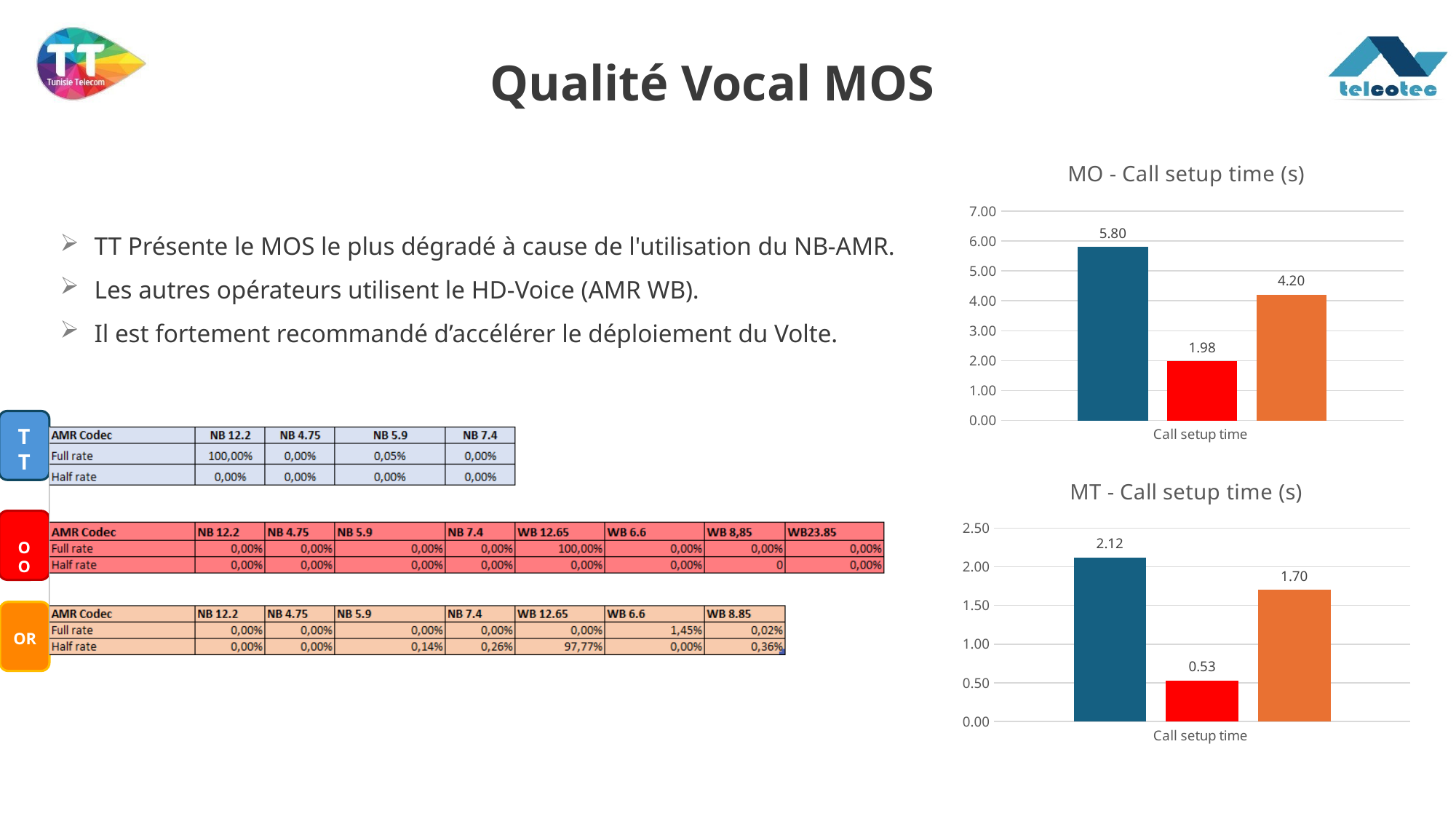
In the 'MO - Call setup time (s)' chart, what value is shown on the red bar? 1.98 In the 'MO - Call setup time (s)' chart, what is the difference between the blue bar and the orange bar? 1.60 In the 'MT - Call setup time (s)' chart, what value is shown on the red bar? 0.53 In the 'MT - Call setup time (s)' chart, which coloured bar has the lowest value? red In the 'MO - Call setup time (s)' chart, which coloured bar has the highest value? blue What kind of chart is the 'MO - Call setup time (s)' chart? bar chart In the 'MT - Call setup time (s)' chart, what is the difference between the blue bar and the red bar? 1.59 In the 'MO - Call setup time (s)' chart, what value is shown on the orange bar? 4.20 In the 'MO - Call setup time (s)' chart, what value is shown on the blue bar? 5.80 In the 'MT - Call setup time (s)' chart, what value is shown on the blue bar? 2.12 In the 'MT - Call setup time (s)' chart, is the orange bar greater or less than 1.50? greater In the 'MT - Call setup time (s)' chart, what value is shown on the orange bar? 1.70